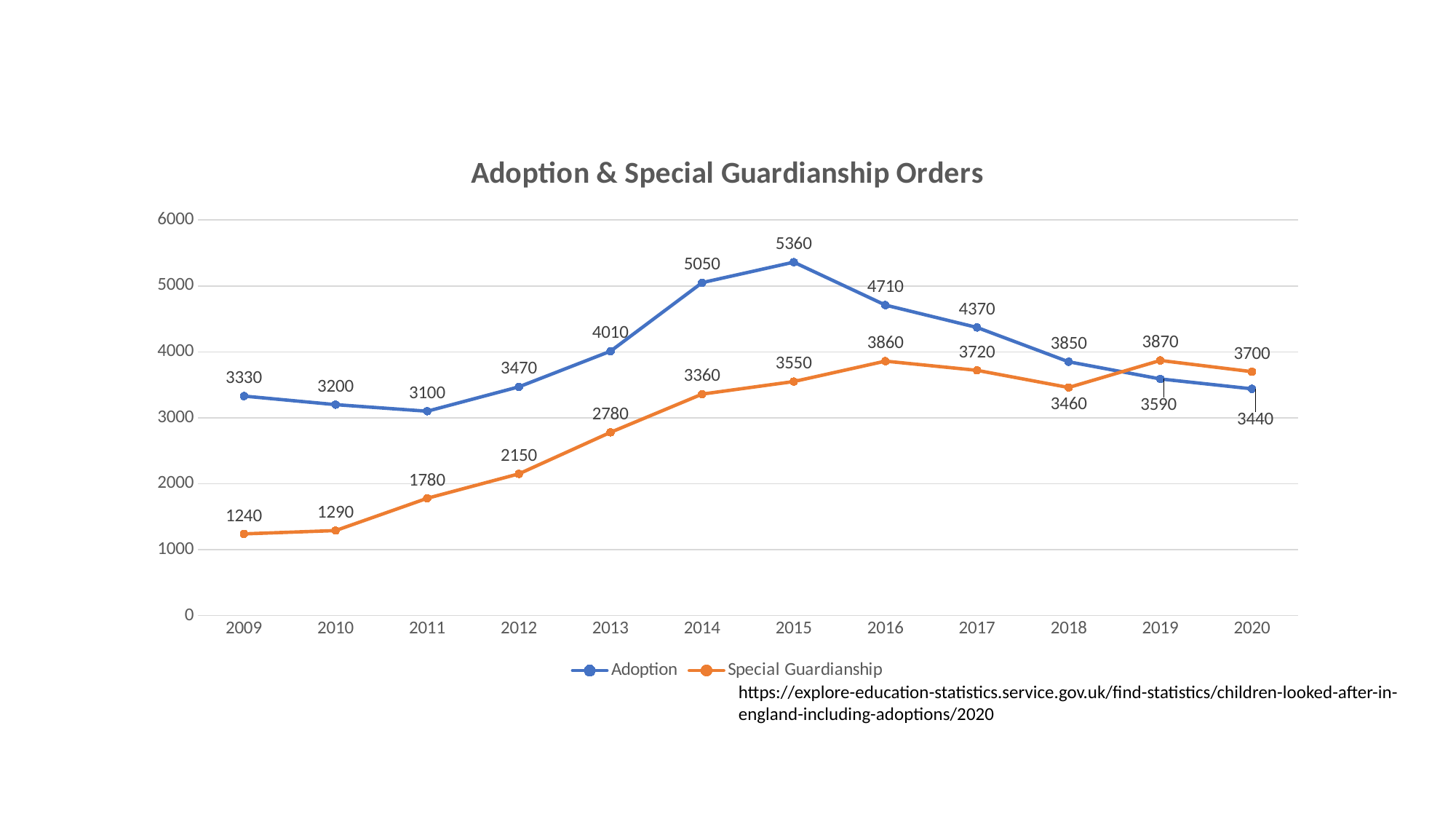
Does the Special Guardianship series rise or fall from 2009 to 2016? Rise In which year is the Special Guardianship series lowest? 2009 What is the Special Guardianship value for 2012? 2150 In which year is the Adoption series highest? 2015 What kind of chart is shown? Line chart What is the difference between the Adoption and Special Guardianship values in 2014? 1690 How many series does the legend list? 2 Which series has the larger value in 2019, Adoption or Special Guardianship? Special Guardianship Is the Adoption value for 2013 greater or less than 4000? greater How many years are shown on the x axis? 12 What is the Adoption value for 2015? 5360 What is the title of the chart? Adoption & Special Guardianship Orders